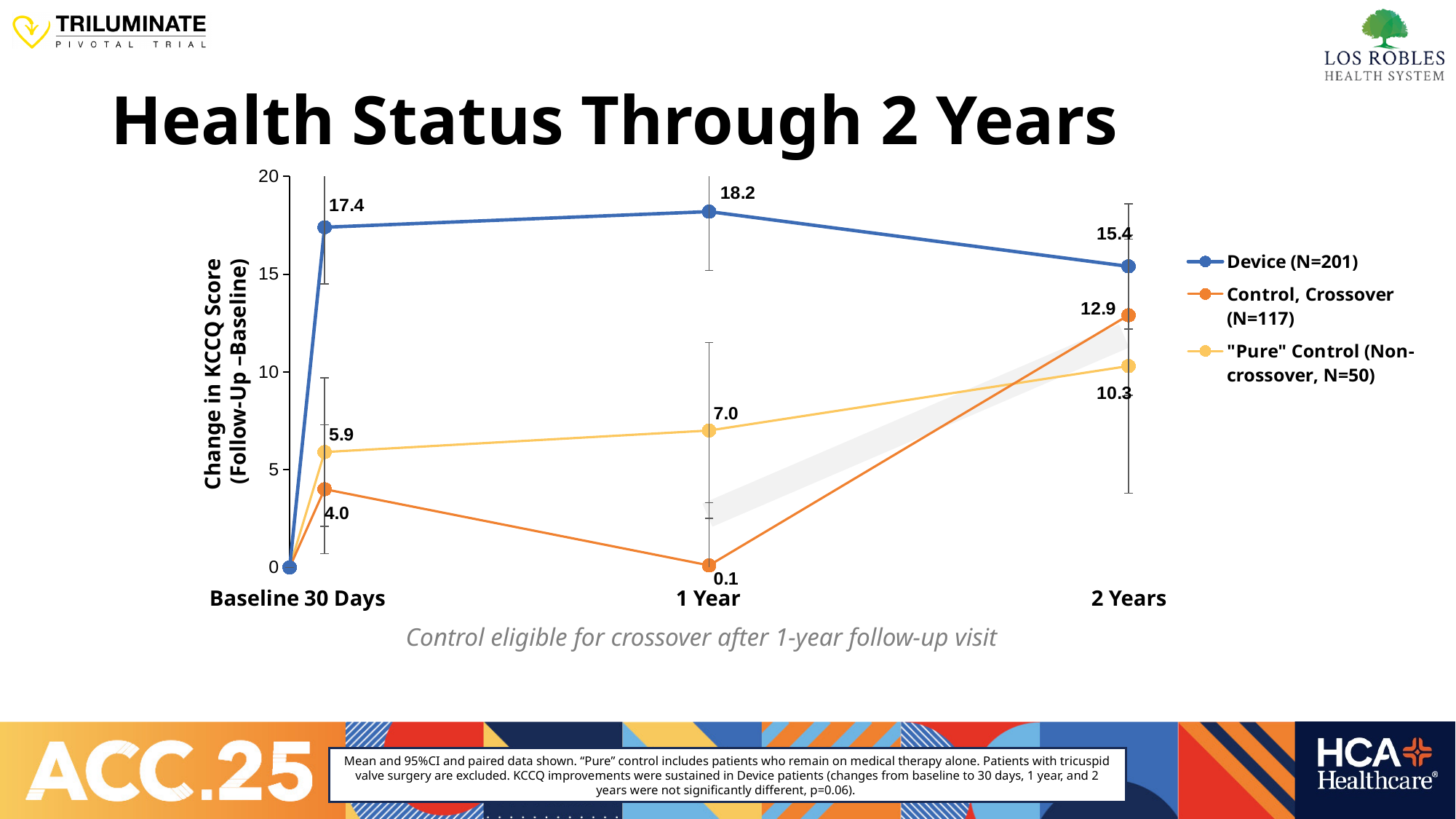
At which time point does the Device group reach its highest change in KCCQ score? 1 Year At 2 Years, which group has the larger change in KCCQ score: Control, Crossover or "Pure" Control? Control, Crossover What is the change in KCCQ score for the Control, Crossover group at 2 Years? 12.9 How many series does the legend list? 3 What is the difference between the Device and "Pure" Control values at 2 Years? 5.1 What is the change in KCCQ score for the Device group at 1 Year? 18.2 What is the change in KCCQ score for the "Pure" Control group at 30 Days? 5.9 Does the "Pure" Control group's change in KCCQ score rise or fall from 30 Days to 2 Years? Rise Is the Device group's value at 30 Days greater or less than 15? greater At which time point is the Control, Crossover group's change in KCCQ score lowest (excluding Baseline)? 1 Year What is the sample size (N) of the Device group shown in the legend? 201 What kind of chart is shown on the slide? Line chart